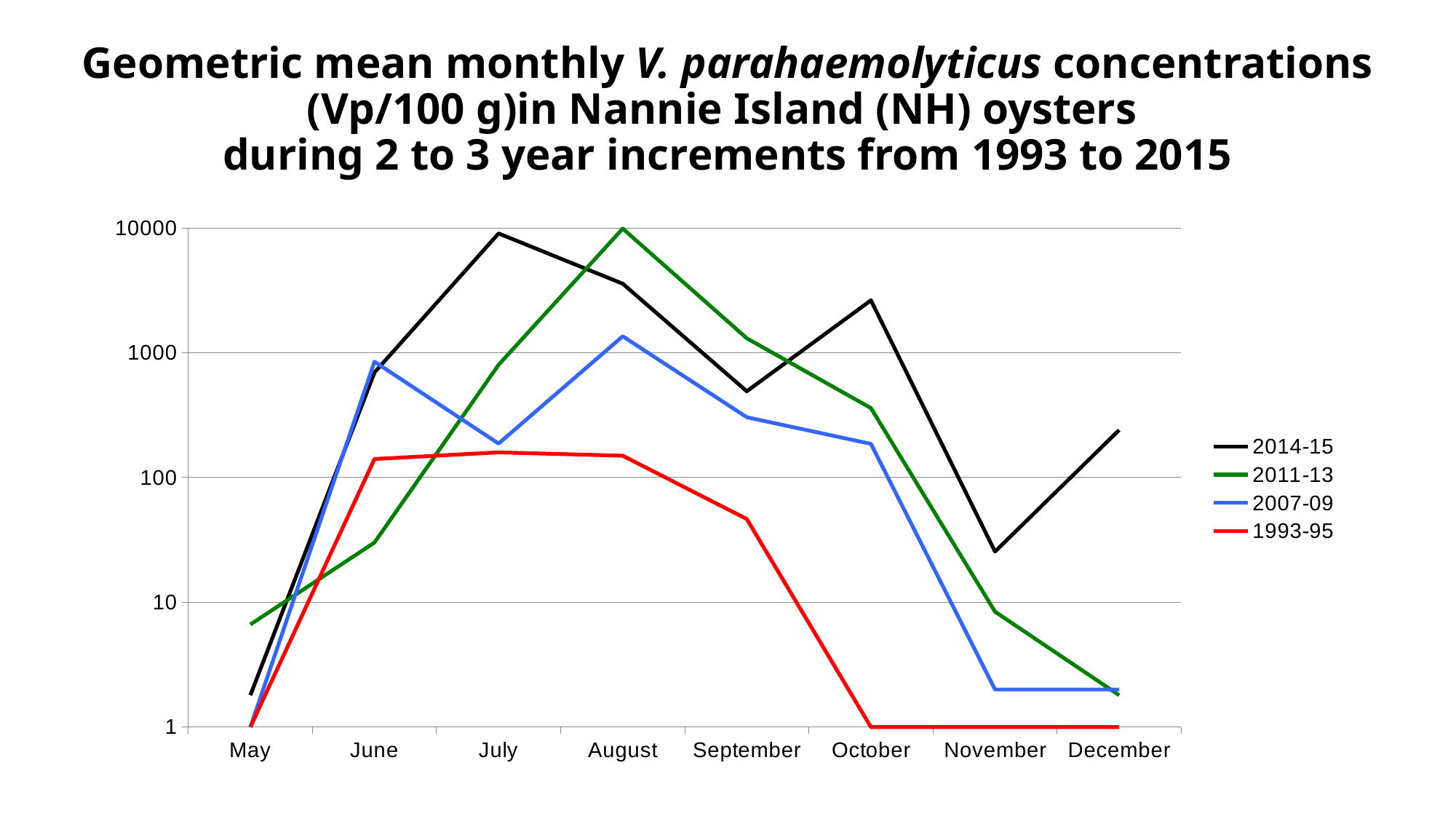
What is the value for 1993-95 in October? 1 Which series has the highest value in August? 2011-13 What kind of chart is shown on the slide? line chart Which series has the lowest value in September? 1993-95 In November, which is larger: the value for 2014-15 or the value for 2011-13? 2014-15 In which month does the 2014-15 series reach its highest value? July How many series does the legend list? 4 Is the value for 2007-09 in July greater or less than 1000? less Is the value for 2014-15 in October greater or less than 1000? greater How many months are shown along the x axis? 8 Which colour is used for the 2007-09 series? blue